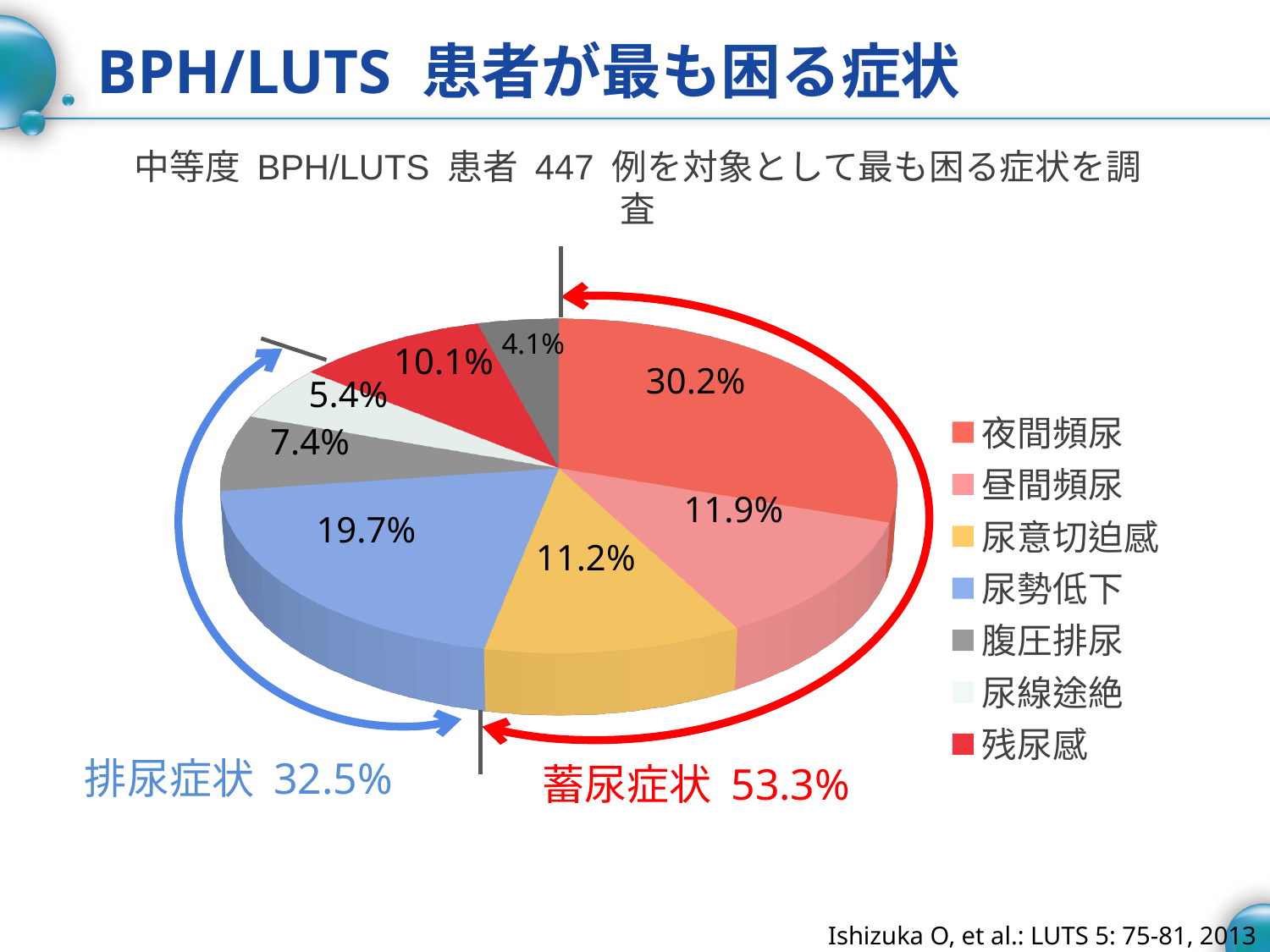
What is the difference in percentage points between 夜間頻尿 and 尿勢低下? 10.5 What is the value shown for 腹圧排尿? 7.4% Which is larger, the share for 昼間頻尿 or the share for 尿意切迫感? 昼間頻尿 Which symptom has the largest share of the pie? 夜間頻尿 What is the value shown for 残尿感? 10.1% How many entries does the legend list? 7 What is the value shown for 尿勢低下? 19.7% What combined percentage is given for 蓄尿症状 on the slide? 53.3% What percentage of patients reported 夜間頻尿 as their most bothersome symptom? 30.2% Which of the legend categories has the smallest share of the pie? 尿線途絶 What type of chart is shown on the slide? pie chart What is the value shown for 尿意切迫感? 11.2%